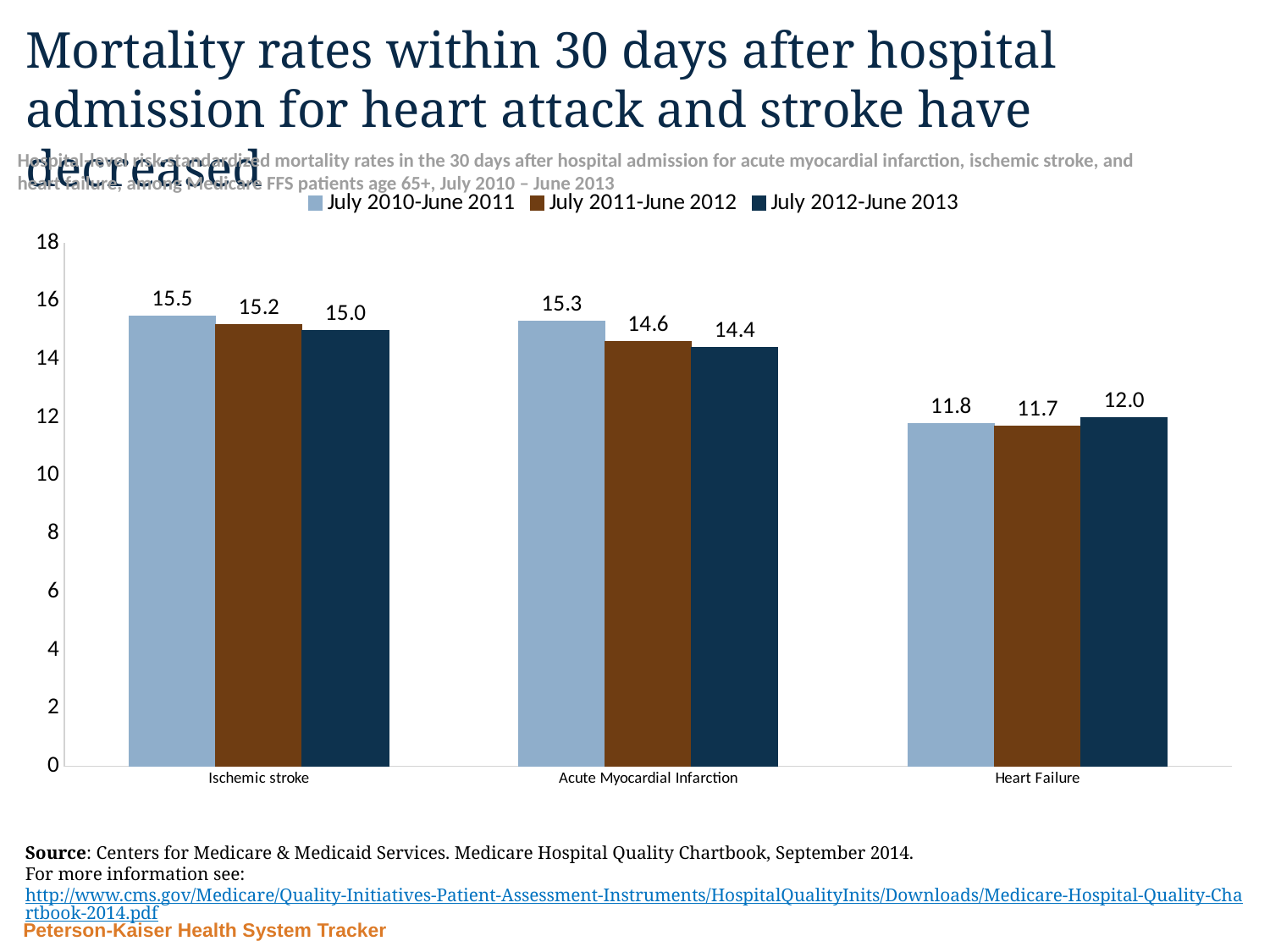
Which condition has the lowest mortality rate in July 2012-June 2013? Heart Failure What kind of chart is shown on the slide? bar chart Which is larger: the Acute Myocardial Infarction rate in July 2010-June 2011 or the Heart Failure rate in July 2010-June 2011? Acute Myocardial Infarction Did the Acute Myocardial Infarction mortality rate rise or fall from July 2010-June 2011 to July 2012-June 2013? fall What is the mortality rate for Ischemic stroke in July 2010-June 2011? 15.5 Which condition has the highest mortality rate in July 2010-June 2011? Ischemic stroke What is the difference between the Ischemic stroke mortality rate in July 2010-June 2011 and in July 2012-June 2013? 0.5 Is the Heart Failure mortality rate in July 2012-June 2013 greater or less than 14? less What is the mortality rate for Heart Failure in July 2011-June 2012? 11.7 How many conditions are shown on the x axis? 3 What is the mortality rate for Acute Myocardial Infarction in July 2012-June 2013? 14.4 How many series does the legend list? 3